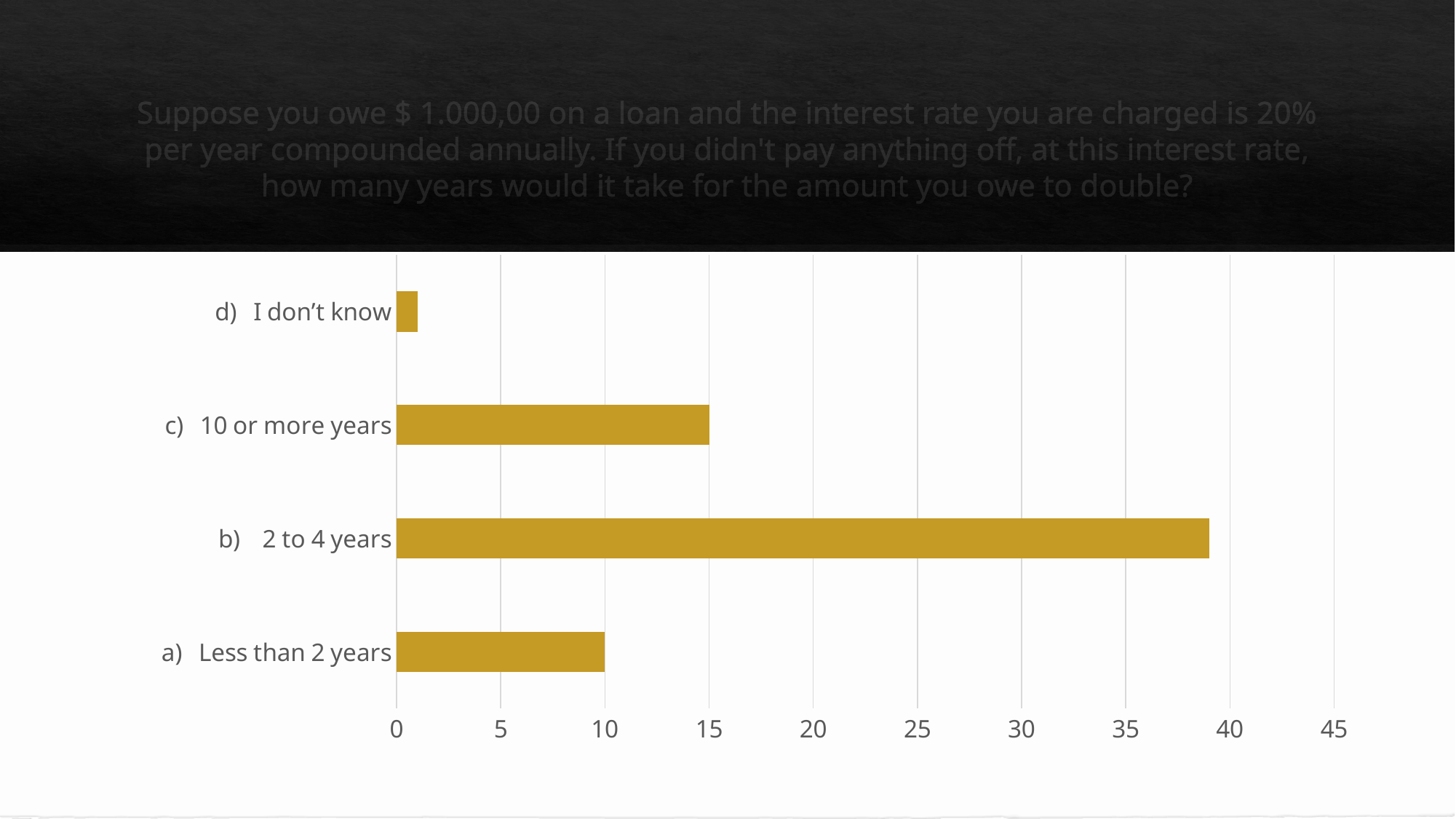
Which is larger, the value for "c) 10 or more years" or the value for "a) Less than 2 years"? c) 10 or more years What is the difference between the values for "c) 10 or more years" and "a) Less than 2 years"? 5 Is the value for "b) 2 to 4 years" greater or less than 35? greater What is the value for "c) 10 or more years"? 15 Which answer category has the lowest value? d) I don't know What kind of chart is shown on the slide? bar chart What is the value for "a) Less than 2 years"? 10 What colour are the bars in the chart? gold Is the value for "d) I don't know" greater or less than 5? less How many answer categories are plotted in the chart? 4 Is the value for "b) 2 to 4 years" greater or less than 40? less Which answer category has the highest value? b) 2 to 4 years